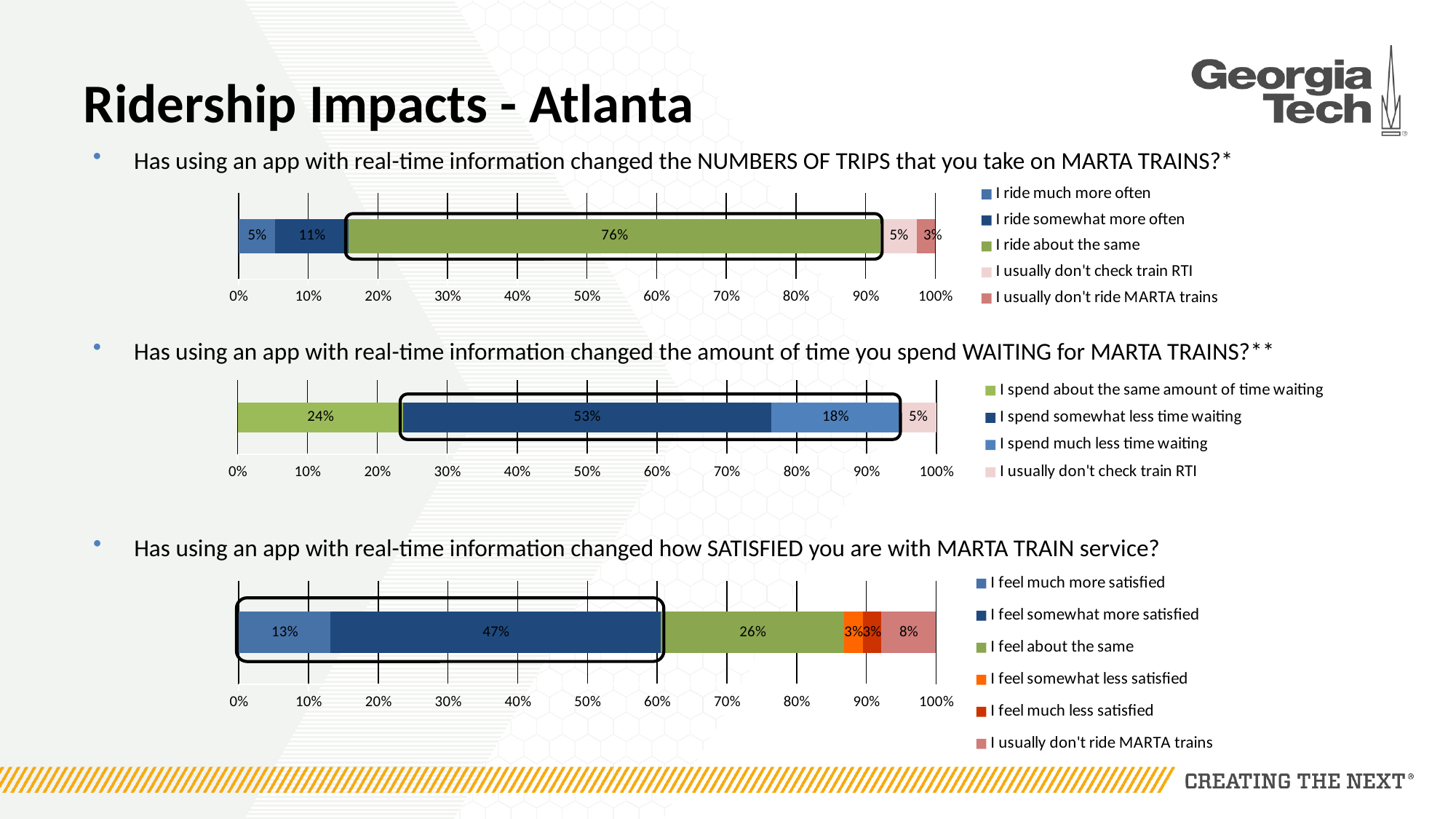
How many series does the legend of the middle chart (WAITING time) list? 4 In the top chart about NUMBERS OF TRIPS, what percentage said 'I ride somewhat more often'? 11% In the middle chart about WAITING time, what is the difference between 'I spend about the same amount of time waiting' and 'I spend much less time waiting'? 6% In the middle chart about WAITING time, which is larger: 'I spend about the same amount of time waiting' or 'I spend much less time waiting'? I spend about the same amount of time waiting In the top chart about NUMBERS OF TRIPS on MARTA trains, what percentage of respondents said 'I ride about the same'? 76% In the middle chart about time spent WAITING for MARTA trains, what percentage said 'I spend somewhat less time waiting'? 53% In the bottom chart about SATISFACTION, what percentage said 'I usually don't ride MARTA trains'? 8% In the bottom chart about SATISFACTION, what is the combined share of 'I feel much more satisfied' and 'I feel somewhat more satisfied'? 60% In the bottom chart about how SATISFIED respondents are with MARTA train service, what percentage said 'I feel somewhat more satisfied'? 47% In the top chart about NUMBERS OF TRIPS, which response has the largest share? I ride about the same How many series does the legend of the top chart (NUMBERS OF TRIPS) list? 5 What type of chart is used for the three charts on this slide? Stacked bar chart